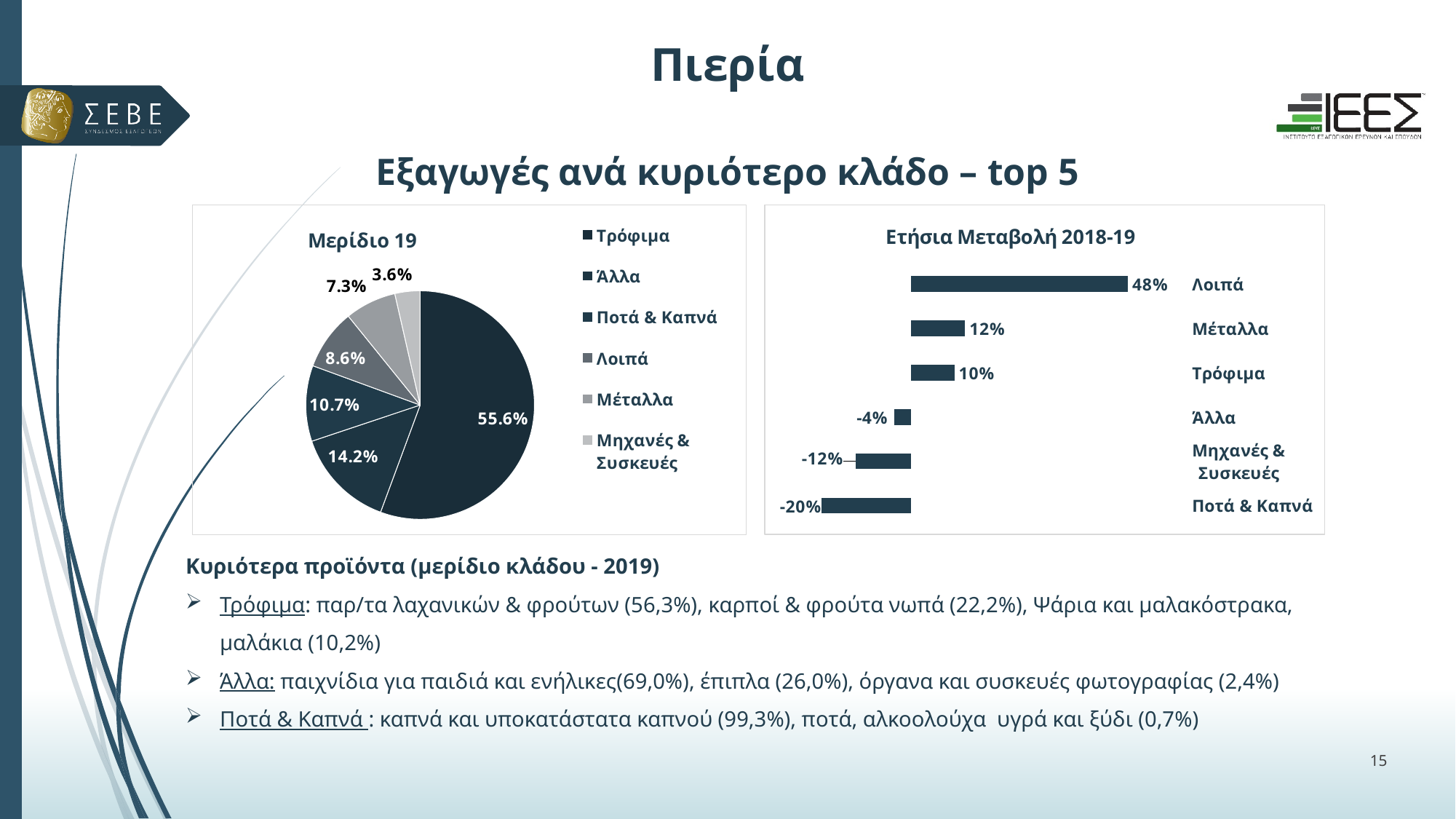
In the pie chart 'Μερίδιο 19', which category has the largest share? Τρόφιμα In the chart 'Ετήσια Μεταβολή 2018-19', which category has the lowest value? Ποτά & Καπνά In the chart 'Ετήσια Μεταβολή 2018-19', what is the value for Ποτά & Καπνά? -20% In the chart 'Ετήσια Μεταβολή 2018-19', which is larger, the value for Μέταλλα or the value for Τρόφιμα? Μέταλλα In the pie chart 'Μερίδιο 19', what is the difference between the shares of Άλλα and Ποτά & Καπνά? 3.5% In the pie chart 'Μερίδιο 19', which category has the smallest share? Μηχανές & Συσκευές In the chart 'Ετήσια Μεταβολή 2018-19', what is the difference between the values for Λοιπά and Μέταλλα? 36% In the pie chart 'Μερίδιο 19', what is the share for Μηχανές & Συσκευές? 3.6% In the pie chart 'Μερίδιο 19', what is the share for Τρόφιμα? 55.6% What kind of chart is 'Ετήσια Μεταβολή 2018-19'? Bar chart In the pie chart 'Μερίδιο 19', how many categories does the legend list? 6 In the chart 'Ετήσια Μεταβολή 2018-19', what is the value for Λοιπά? 48%